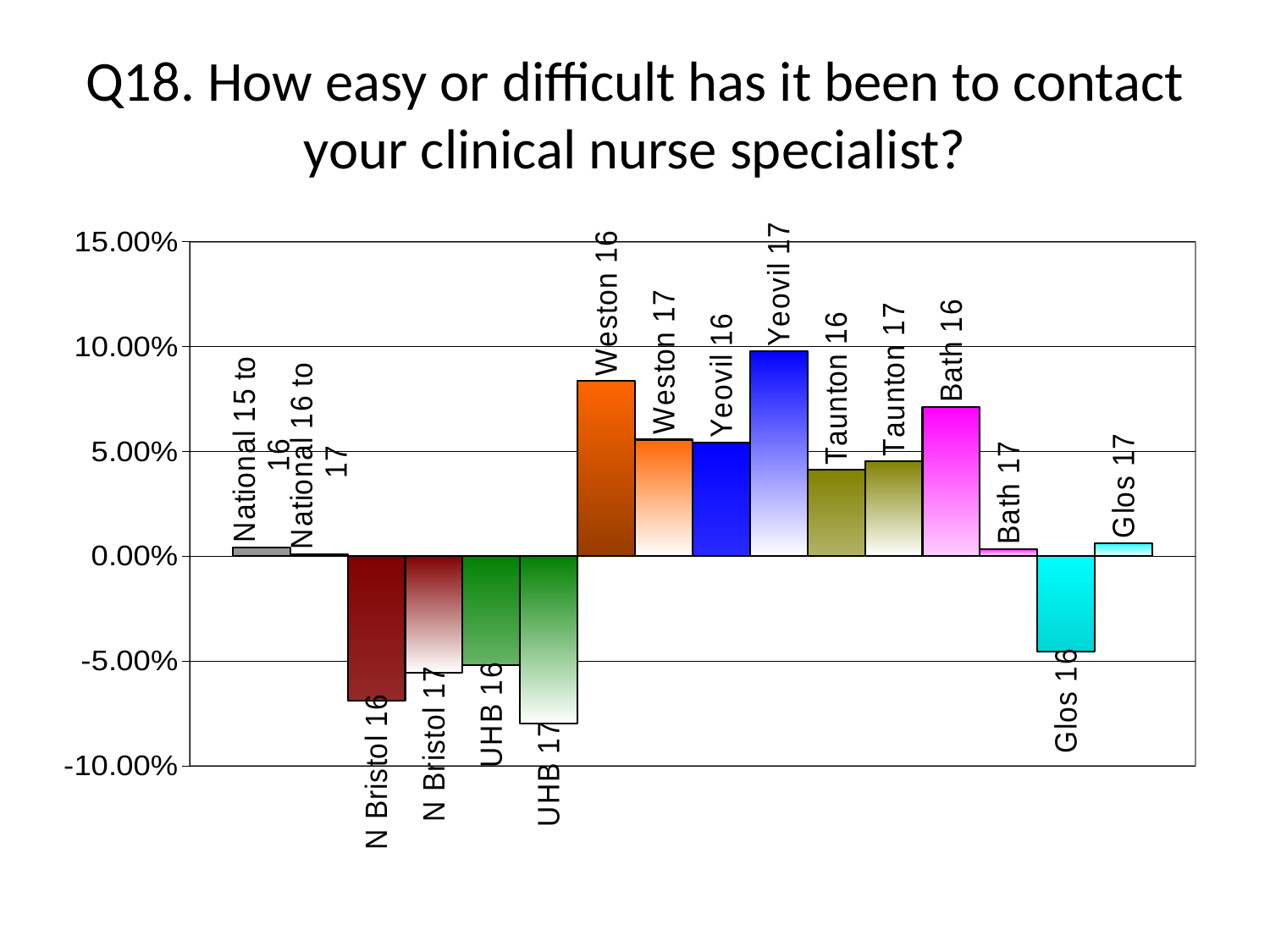
Is the value for Weston 16 greater or less than 5.00%? greater Which is larger, the value for Glos 16 or Glos 17? Glos 17 Is the value for Bath 16 greater or less than 5.00%? greater Is the value for Taunton 16 greater or less than 5.00%? less What is the title of the slide? Q18. How easy or difficult has it been to contact your clinical nurse specialist? Which is larger, the value for Yeovil 16 or Yeovil 17? Yeovil 17 Which category has the lowest value in the chart? UHB 17 Which is larger, the value for Weston 16 or Weston 17? Weston 16 Which category has the highest value in the chart? Yeovil 17 How many categories (bars) are plotted in the chart? 16 What kind of chart is shown on the slide? bar chart